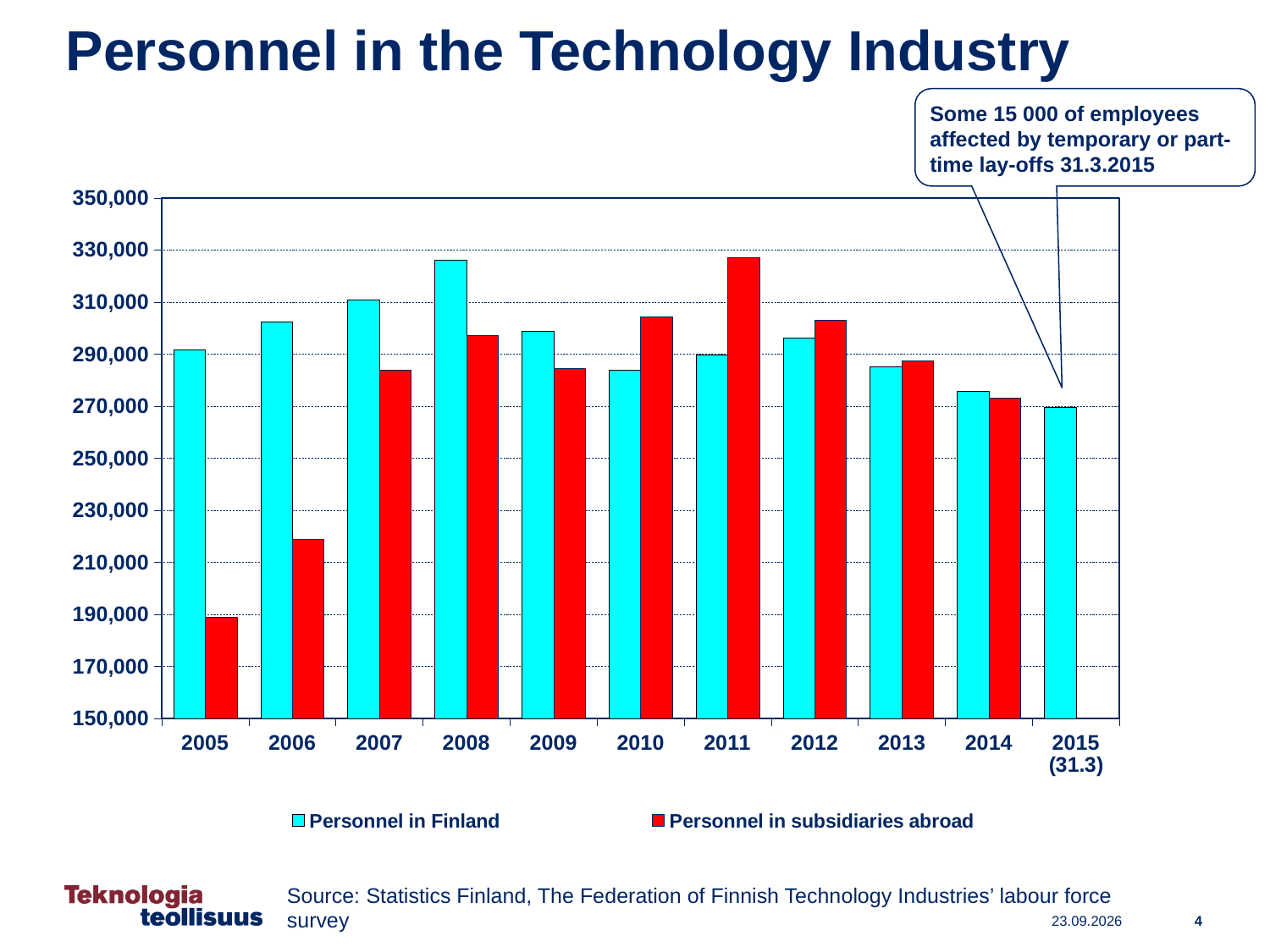
How many series does the legend list? 2 Does Personnel in Finland rise or fall from 2008 to 2015 (31.3)? fall How many years (categories) are shown on the x axis? 11 Which colour represents Personnel in subsidiaries abroad in the legend? Red What kind of chart is shown on the slide? Bar chart In 2011, which is larger: Personnel in Finland or Personnel in subsidiaries abroad? Personnel in subsidiaries abroad In which year is Personnel in Finland highest? 2008 In which year is Personnel in Finland lowest? 2015 (31.3) Is the value for Personnel in subsidiaries abroad in 2006 greater or less than 230,000? less Is the value for Personnel in Finland in 2008 greater or less than 310,000? greater In which year is Personnel in subsidiaries abroad lowest? 2005 In which year is Personnel in subsidiaries abroad highest? 2011